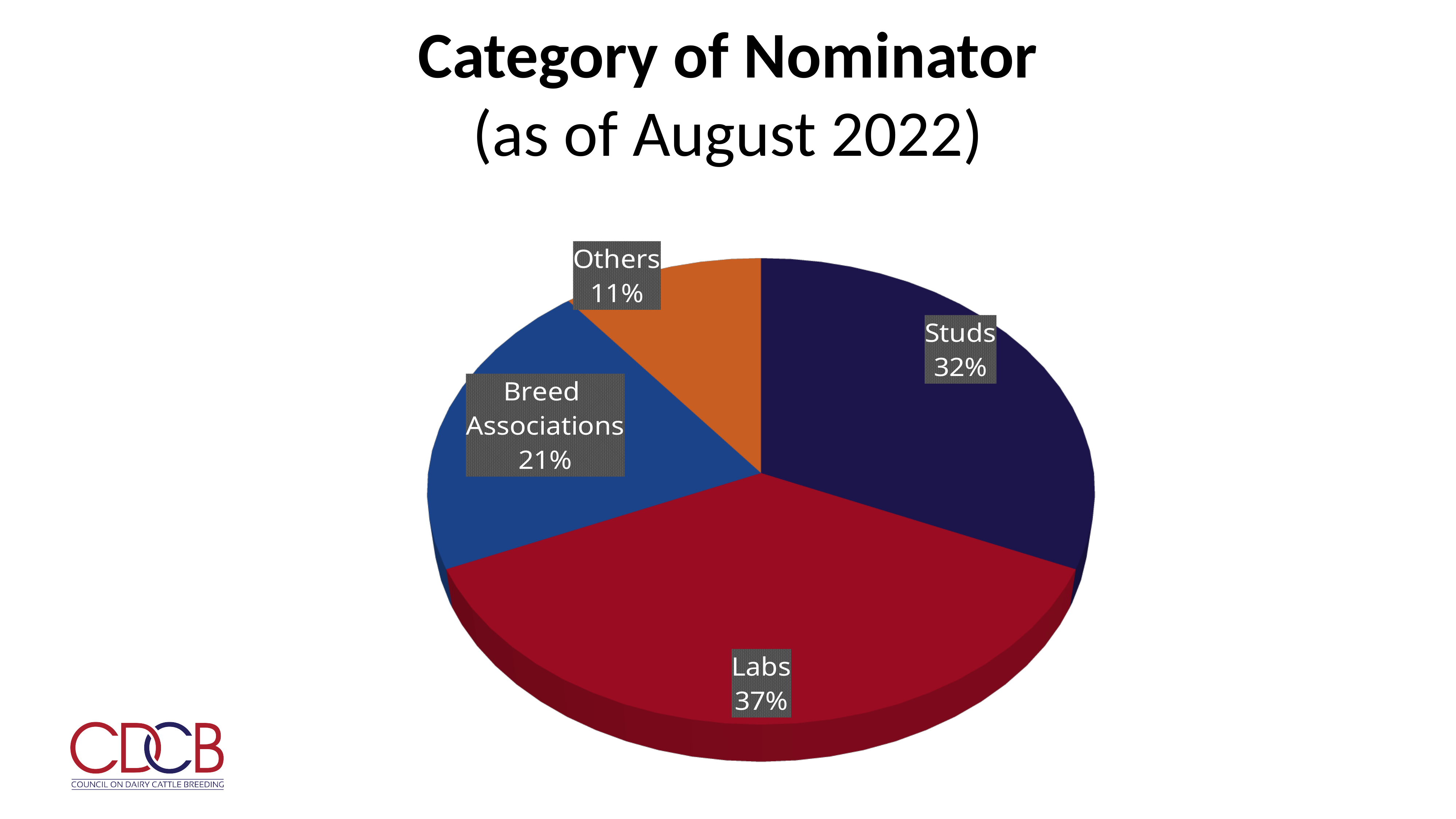
What percentage is shown for Studs? 32% What is the title of the chart? Category of Nominator (as of August 2022) Which category has the smallest share of the pie? Others What is the difference in percentage points between Labs and Studs? 5 What is the difference in percentage points between Breed Associations and Others? 10 What share of the pie does Labs account for? 37% Which is larger, the share for Studs or the share for Breed Associations? Studs What kind of chart is shown on the slide? Pie chart What percentage is shown for Breed Associations? 21% What percentage is shown for Others? 11% Which category has the largest share of the pie? Labs How many categories are shown in the pie chart? 4